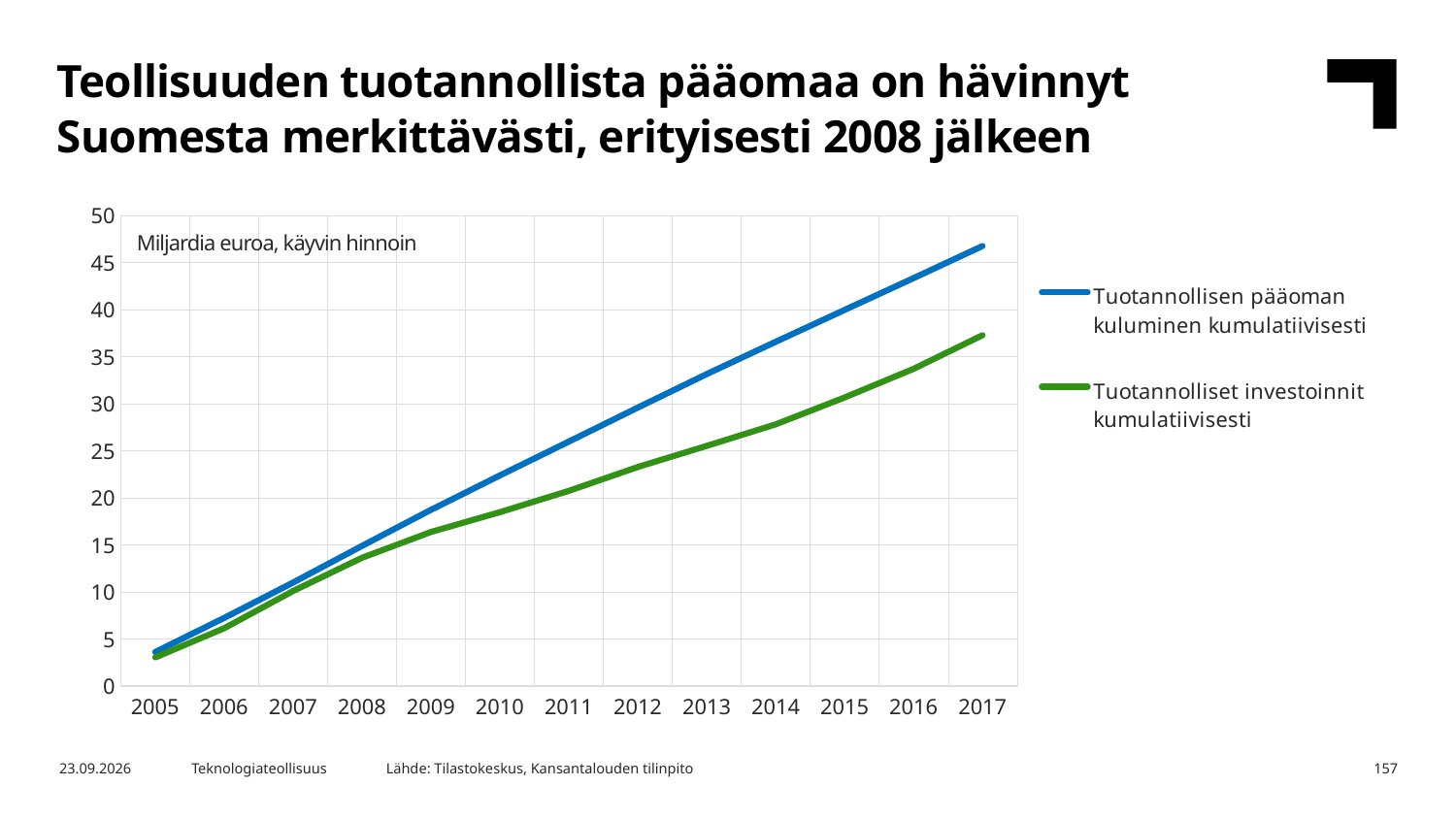
How many years are shown on the x axis? 13 Is the value for 'Tuotannolliset investoinnit kumulatiivisesti' in 2017 greater or less than 40? less How many series does the legend list? 2 What colour is the line for 'Tuotannolliset investoinnit kumulatiivisesti'? green Is the value for 'Tuotannollisen pääoman kuluminen kumulatiivisesti' in 2017 greater or less than 45? greater In 2017, which series has the higher value: 'Tuotannollisen pääoman kuluminen kumulatiivisesti' or 'Tuotannolliset investoinnit kumulatiivisesti'? Tuotannollisen pääoman kuluminen kumulatiivisesti What unit is stated inside the chart area? Miljardia euroa, käyvin hinnoin Is the value for 'Tuotannollisen pääoman kuluminen kumulatiivisesti' in 2013 greater or less than 30? greater Do the values for 'Tuotannollisen pääoman kuluminen kumulatiivisesti' rise or fall from 2005 to 2017? rise What kind of chart is shown on the slide? line chart